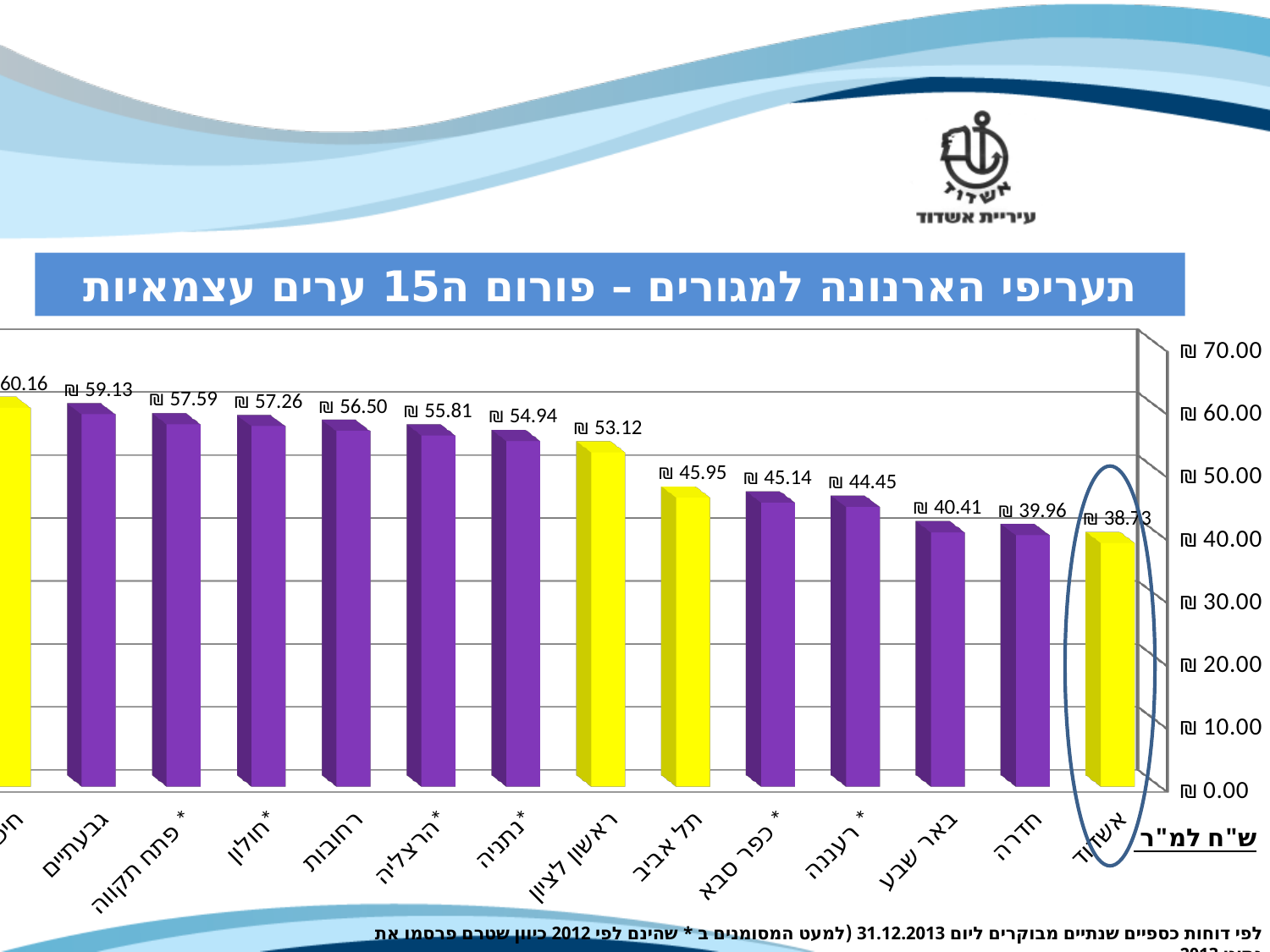
Is the value for ראשון לציון greater or less than ₪ 50.00? greater What is the residential arnona rate shown for אשדוד? ₪ 38.73 What is the difference between the values for באר שבע and חדרה? ₪ 0.45 What is the value shown for תל אביב? ₪ 45.95 Which city's bar is circled on the chart? אשדוד Which has a higher value, רחובות or נתניה? רחובות What is the difference between the values for גבעתיים and אשדוד? ₪ 20.40 What kind of chart is shown on the slide? bar chart Which has a higher value, כפר סבא or רעננה? כפר סבא What is the value shown for גבעתיים? ₪ 59.13 Which city has the lowest arnona rate on the chart? אשדוד What is the value shown for חדרה? ₪ 39.96